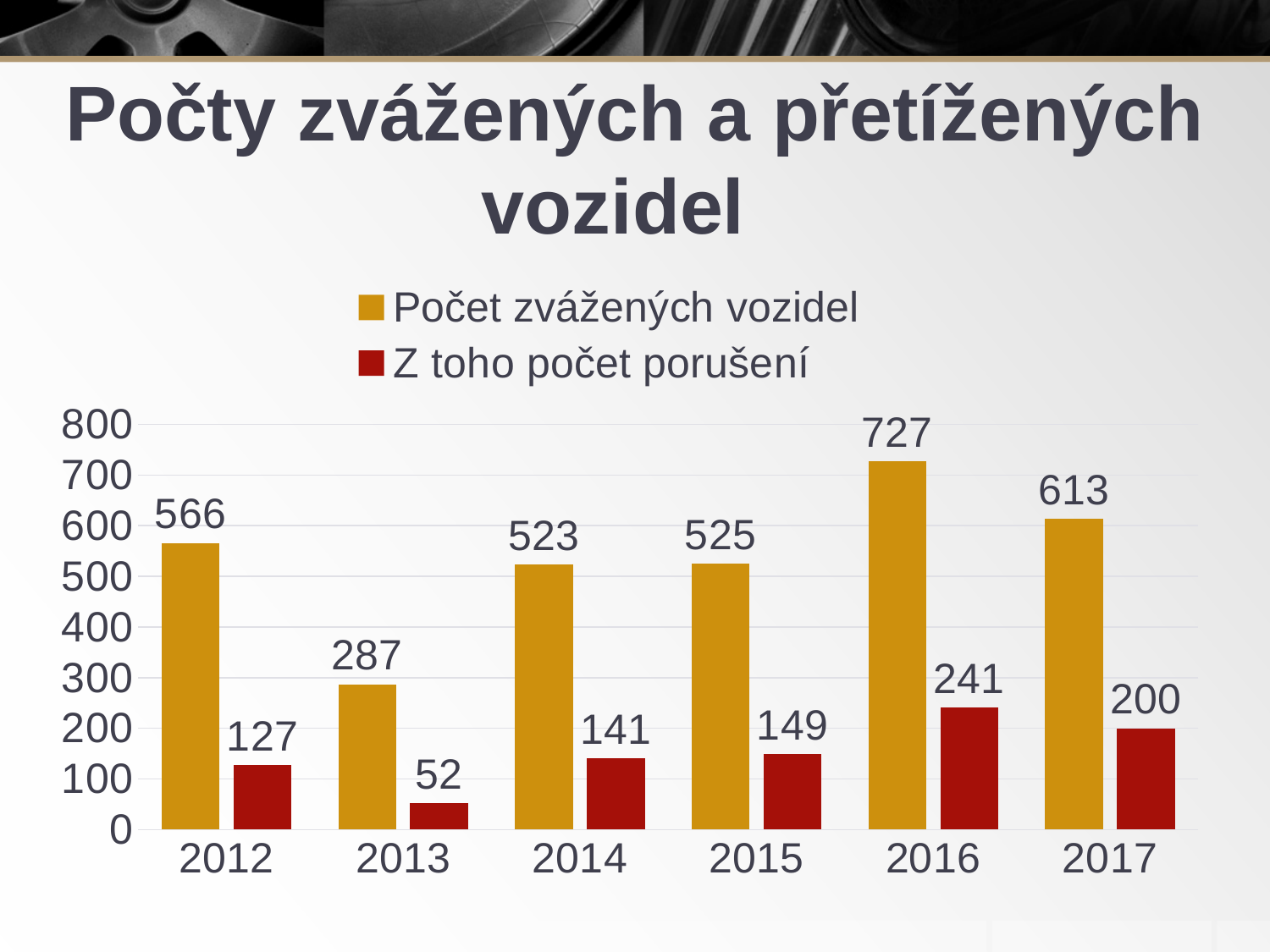
What colour represents 'Z toho počet porušení' in the chart? red How many series does the legend list? 2 In which year was 'Z toho počet porušení' the lowest? 2013 Did 'Z toho počet porušení' rise or fall from 2016 to 2017? fall What is the difference between 'Počet zvážených vozidel' and 'Z toho počet porušení' in 2017? 413 What was the value of 'Počet zvážených vozidel' in 2016? 727 What type of chart is shown on the slide? bar chart In which year was 'Počet zvážených vozidel' the highest? 2016 Which year had a higher 'Z toho počet porušení': 2014 or 2015? 2015 What was the value of 'Z toho počet porušení' in 2013? 52 How many years are shown on the x axis? 6 Is the value of 'Počet zvážených vozidel' in 2013 greater or less than 300? less